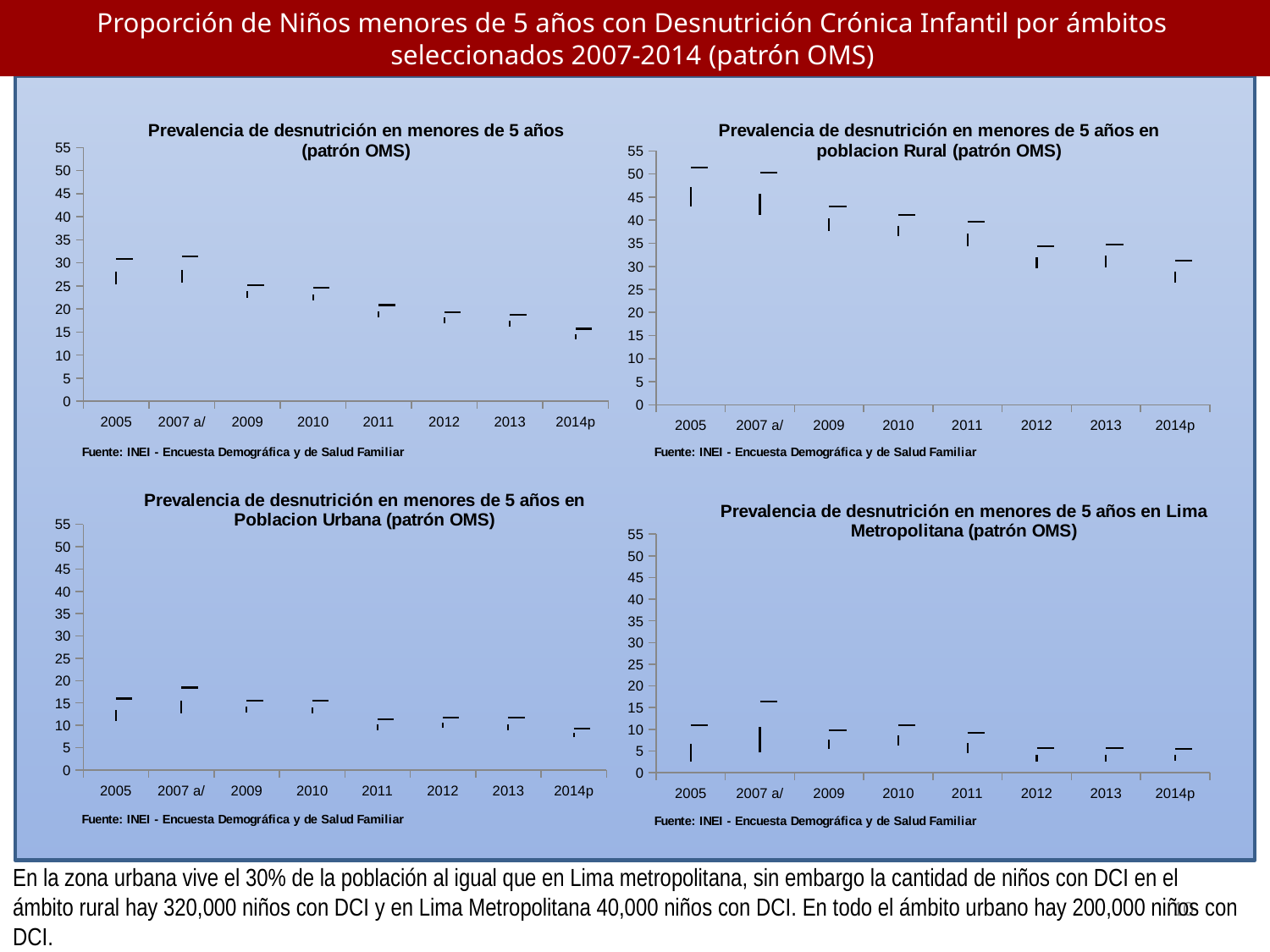
In the top-left chart (Prevalencia de desnutrición en menores de 5 años), how many years are shown on the x axis? 8 In the top-right chart (población Rural), is the value for 2014p greater or less than 35? less In the bottom-left chart (Población Urbana), do the values rise or fall from 2005 to 2014p? fall In the bottom-left chart (Población Urbana), is the value for 2014p greater or less than 10? less In the top-left chart (Prevalencia de desnutrición en menores de 5 años), which year has the lowest value? 2014p In the bottom-right chart (Lima Metropolitana), which year has the highest value? 2007 a/ In the bottom-right chart (Lima Metropolitana), is the value for 2014p greater or less than 10? less In the top-right chart (población Rural), which is larger, the value for 2005 or the value for 2014p? 2005 In the top-left chart (Prevalencia de desnutrición en menores de 5 años), do the values rise or fall from 2005 to 2014p? fall What source is cited below each of the four charts? INEI - Encuesta Demográfica y de Salud Familiar